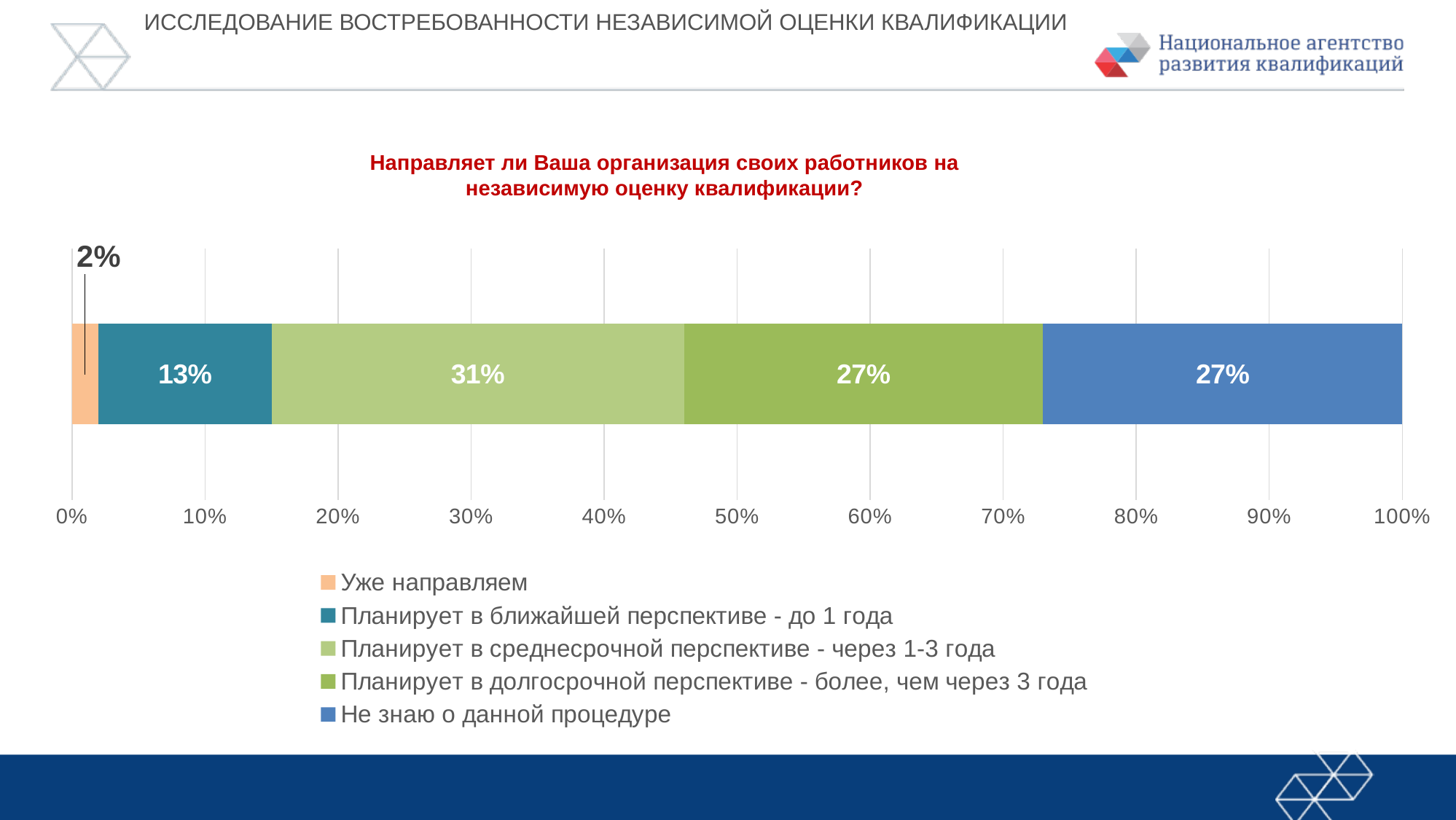
Which is larger: the value for "Планирует в ближайшей перспективе - до 1 года" or the value for "Планирует в долгосрочной перспективе - более, чем через 3 года"? Планирует в долгосрочной перспективе - более, чем через 3 года What is the value for "Не знаю о данной процедуре"? 27% Which response option has the highest share? Планирует в среднесрочной перспективе - через 1-3 года What type of chart is shown on the slide? Stacked bar chart What is the value for "Уже направляем"? 2% What is the value for "Планирует в ближайшей перспективе - до 1 года"? 13% What is the value for "Планирует в среднесрочной перспективе - через 1-3 года"? 31% What is the total of all segments in the stacked bar? 100% Which response option has the lowest share? Уже направляем How many series does the legend list? 5 What is the title of the chart? Направляет ли Ваша организация своих работников на независимую оценку квалификации? What is the difference between the value for "Планирует в среднесрочной перспективе - через 1-3 года" and the value for "Планирует в ближайшей перспективе - до 1 года"? 18%